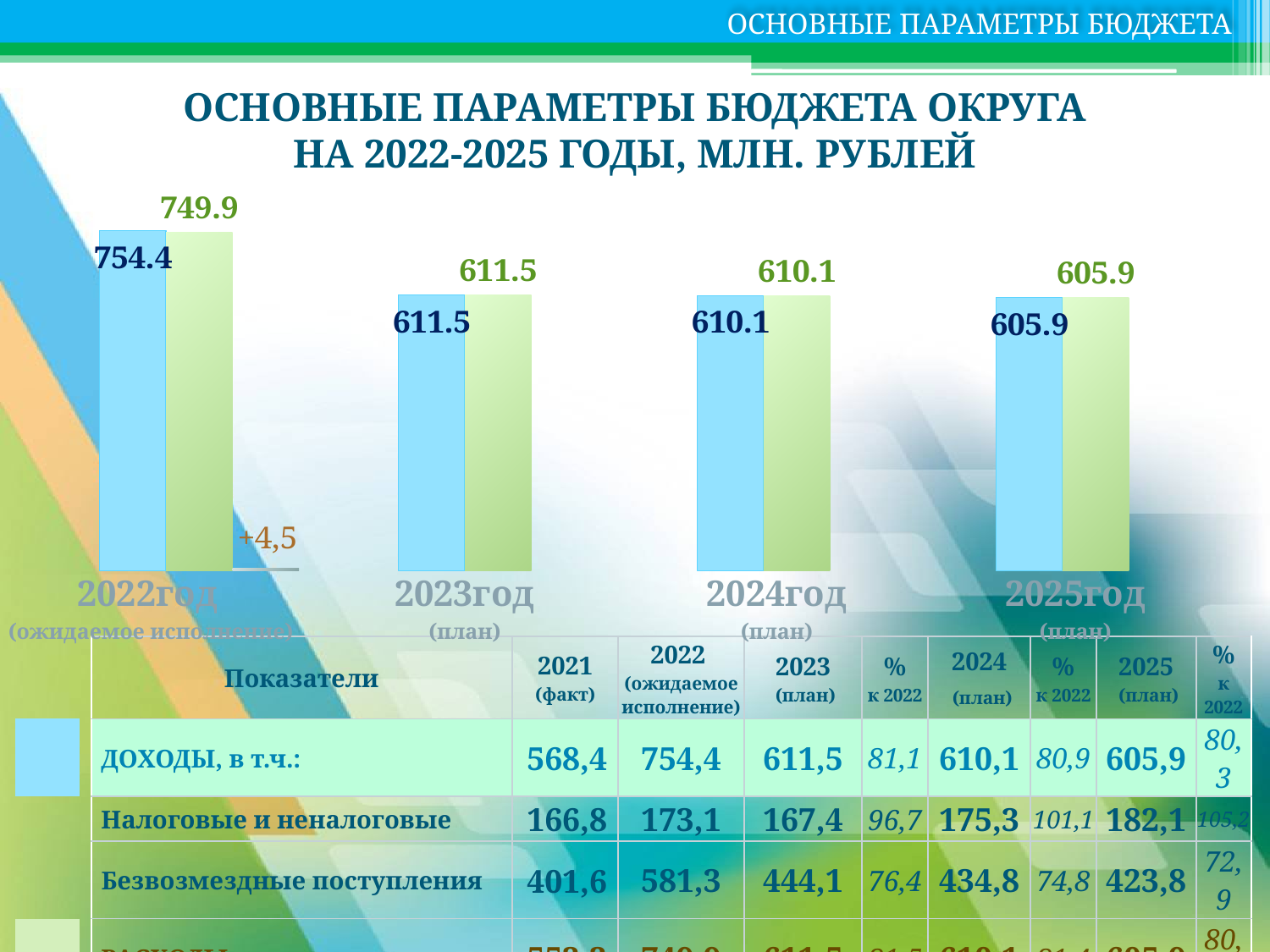
What is the value shown on the green bar for 2025год? 605.9 What is the difference between the blue bar and the green bar for 2022год? 4.5 What is the value shown on the green bar for 2022год? 749.9 Do the blue bar values rise or fall from 2022год to 2025год? fall Which year has the lowest green bar? 2025год What is the value shown on the blue bar for 2022год? 754.4 What kind of chart is shown on the slide? bar chart What is the value shown on the blue bar for 2023год? 611.5 For 2022год, which is larger: the blue bar or the green bar? the blue bar Which year has the highest blue bar? 2022год How many year categories are shown on the chart? 4 By how much does the blue bar value fall from 2022год to 2023год? 142.9